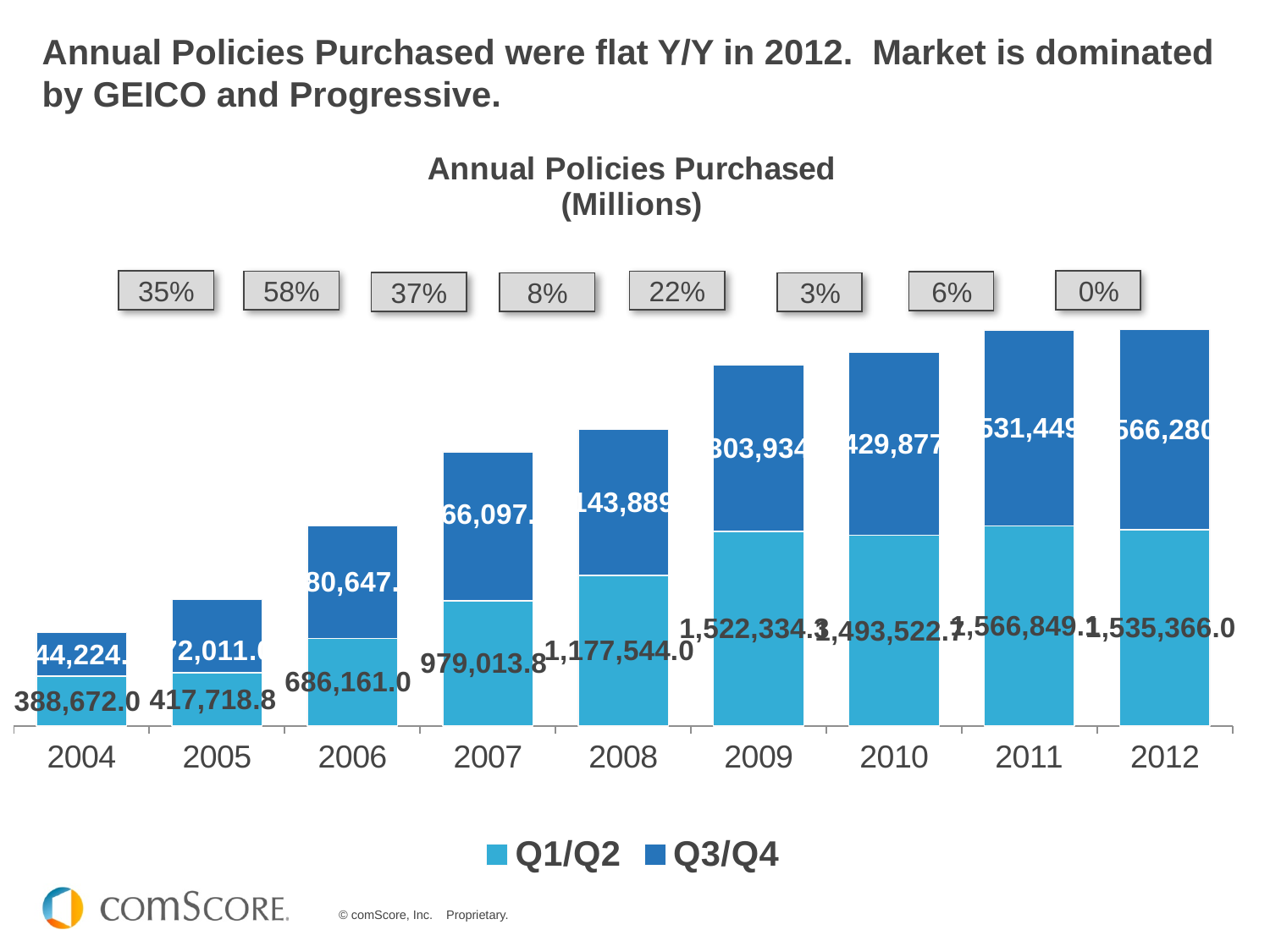
Do the total bar heights generally rise or fall from 2004 to 2012? Rise What is the Q1/Q2 value for 2007? 979,013.8 What is the Q1/Q2 value for 2012? 1,535,366.0 Which year has the larger Q1/Q2 value, 2009 or 2010? 2009 What are the two series named in the chart legend? Q1/Q2 and Q3/Q4 How many series does the legend of the Annual Policies Purchased chart list? 2 What is the difference between the Q1/Q2 values for 2008 and 2007? 198,530.2 Which year has the highest Q1/Q2 value? 2011 What is the Q1/Q2 value for 2004? 388,672.0 What kind of chart is shown on the slide? Stacked bar chart Which year has the lowest Q1/Q2 value? 2004 How many years are shown on the x axis of the Annual Policies Purchased chart? 9